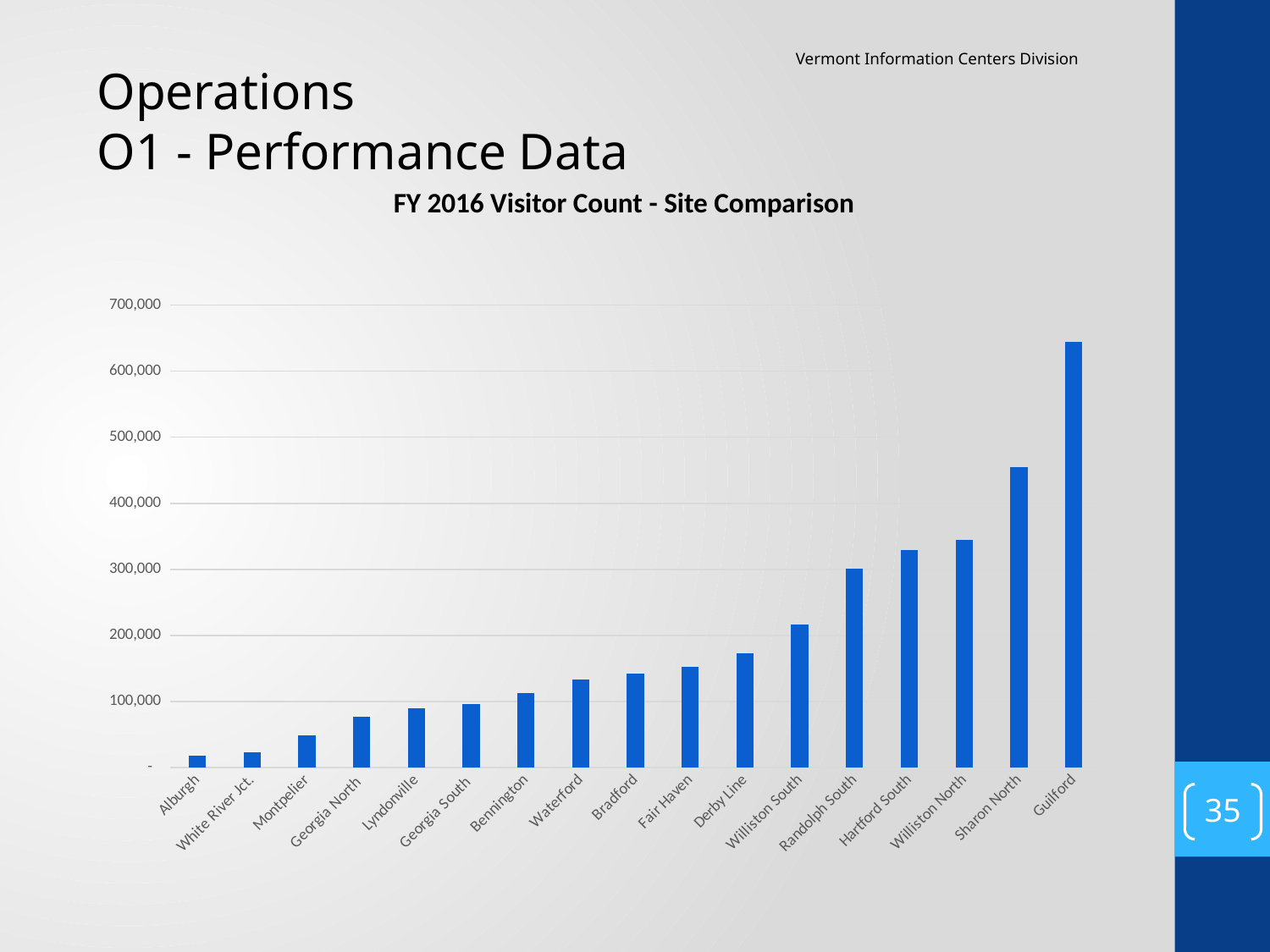
Which site has a higher visitor count, Sharon North or Williston North? Sharon North Is the value for Guilford greater or less than 600,000? greater Which site has the highest visitor count? Guilford What kind of chart is shown on the slide? bar chart Is the value for Derby Line greater or less than 200,000? less Which site has the lowest visitor count? Alburgh Is the value for Williston South greater or less than 200,000? greater How many sites are shown on the x axis of the chart? 17 What is the title of the chart? FY 2016 Visitor Count - Site Comparison Do the visitor counts rise or fall moving from left to right along the x axis? rise